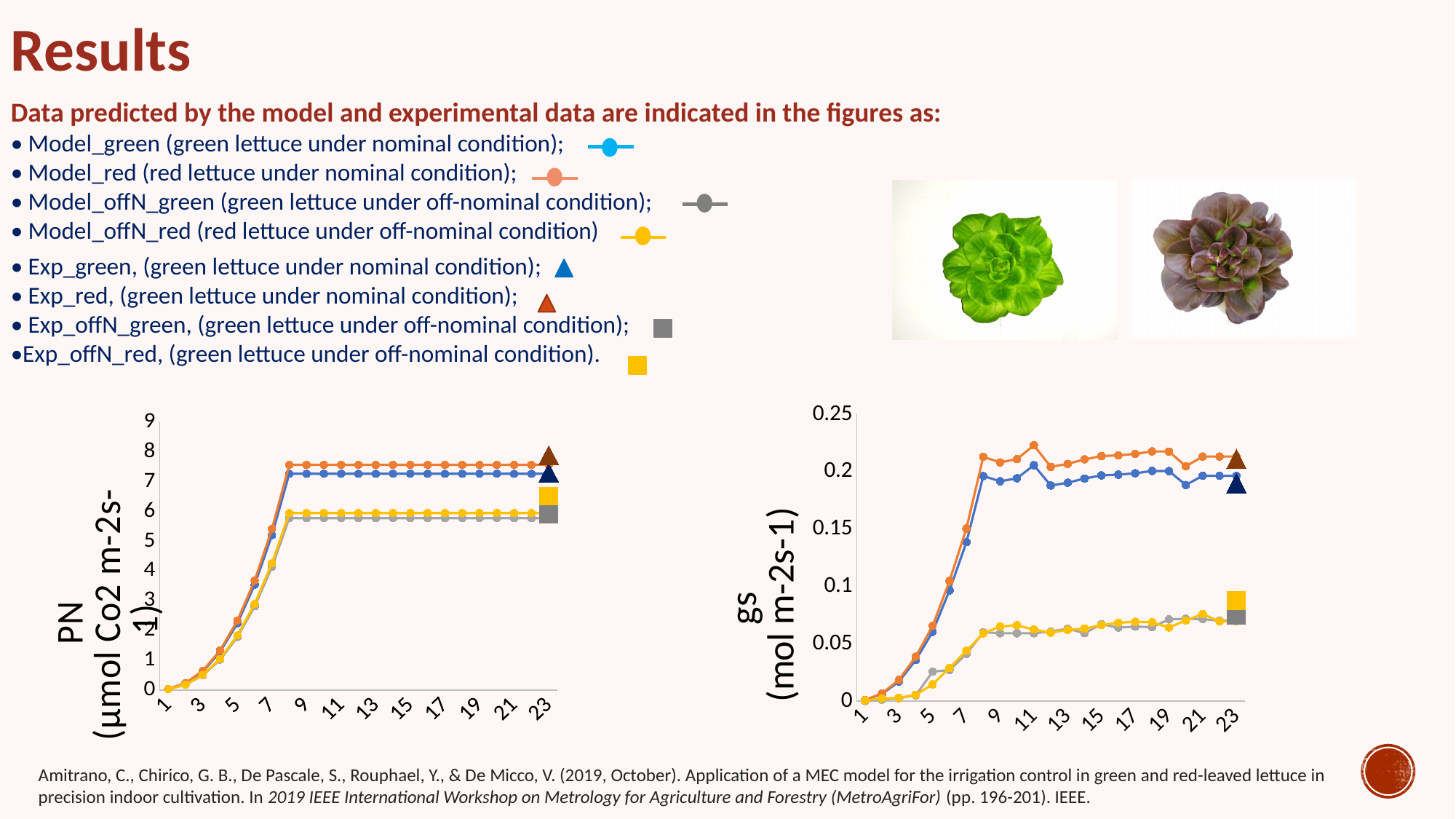
In the right chart (gs), is the value of the Model_offN_red line at day 23 greater or less than 0.1? less What is the highest tick value on the y axis of the left chart (PN)? 9 In the right chart (gs), is the value of the Model_red line at day 23 greater or less than 0.15? greater In the left chart (PN), is the value of the Model_offN_green line at day 23 greater or less than 5? greater In the left chart (PN), do the values of the Model_green line rise or fall from day 1 to day 9? rise What is the highest tick value on the y axis of the right chart (gs)? 0.25 In the left chart (PN), which is larger at day 15: the Model_red line or the Model_offN_green line? Model_red In the right chart (gs), which is larger at day 11: the Model_green line or the Model_offN_green line? Model_green What kind of chart is the right chart (gs)? line chart What kind of chart is the left chart (PN)? line chart How many tick labels are shown on the x axis of the right chart (gs)? 12